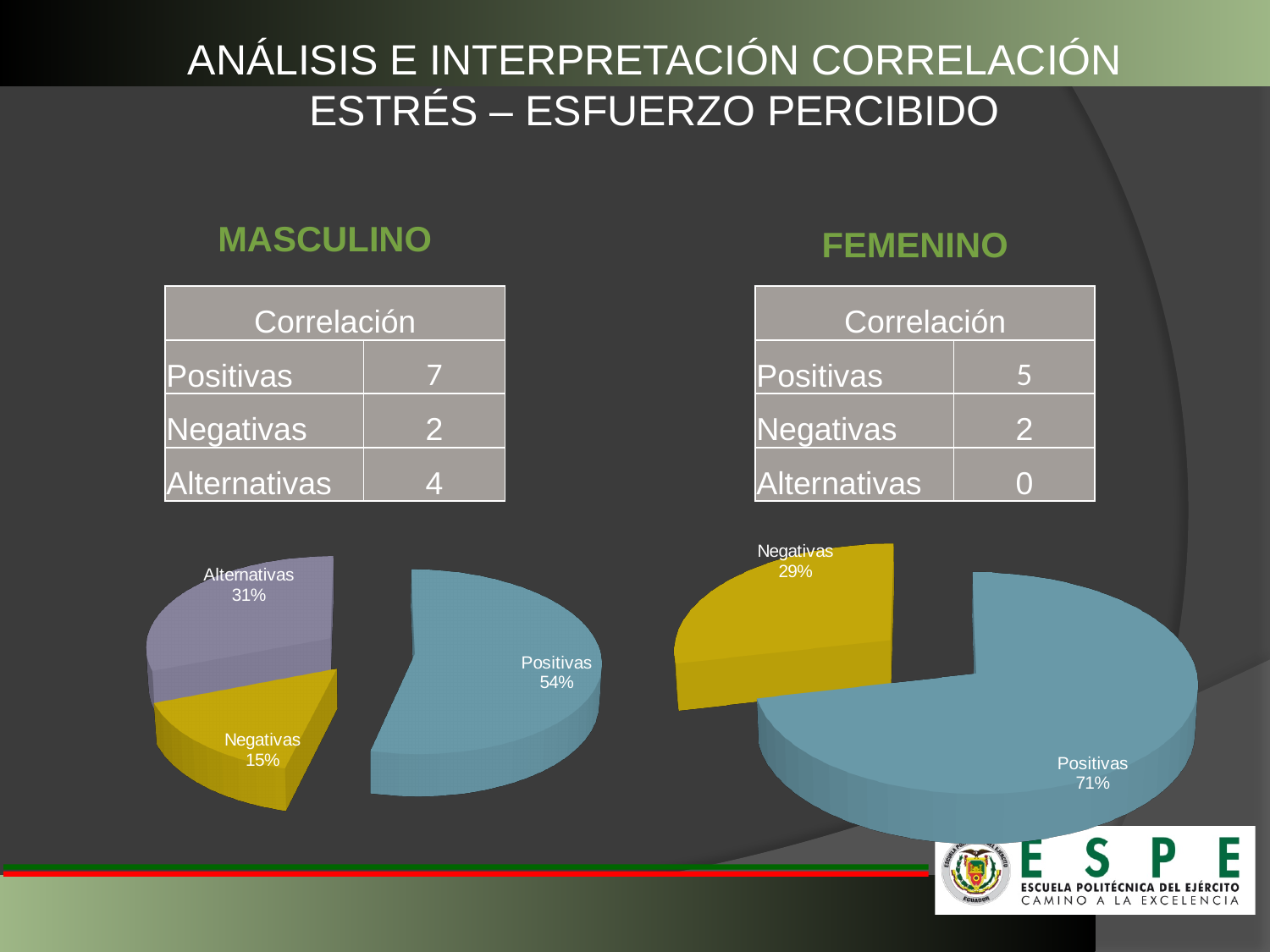
How many slices does the MASCULINO pie chart on the left have? 3 In the FEMENINO pie chart on the right, what share is labelled for Positivas? 71% Which is larger: the Positivas share in the MASCULINO pie chart or the Positivas share in the FEMENINO pie chart? FEMENINO How many slices does the FEMENINO pie chart on the right have? 2 In the FEMENINO pie chart on the right, what is the difference in percentage points between Positivas and Negativas? 42 In the MASCULINO pie chart on the left, what share is labelled for Alternativas? 31% In the MASCULINO pie chart on the left, which slice is the smallest? Negativas In the FEMENINO pie chart on the right, what share is labelled for Negativas? 29% In the MASCULINO pie chart on the left, which slice is the largest? Positivas What kind of chart is used for the MASCULINO data on the left? Pie chart